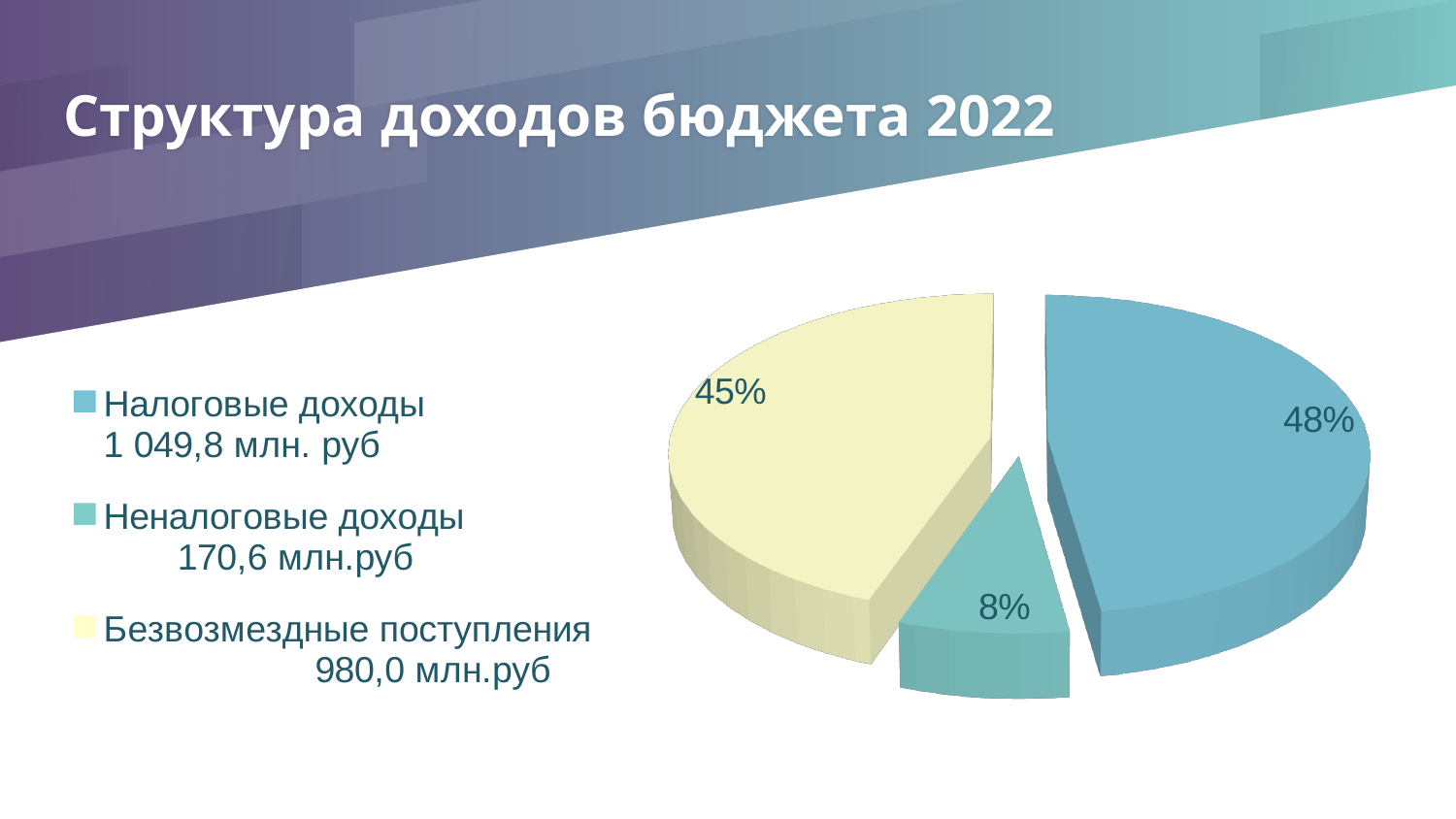
Which category has the smallest slice of the pie? Неналоговые доходы What is the title of the slide containing the pie chart? Структура доходов бюджета 2022 What share of the pie does Неналоговые доходы take? 8% What kind of chart is shown on the slide? pie chart What share of the pie does Безвозмездные поступления take? 45% How many slices does the pie chart have? 3 Which category has the largest slice of the pie? Налоговые доходы What share of the pie does Налоговые доходы take? 48% How many entries does the legend list? 3 What is the difference in percentage points between the Налоговые доходы slice and the Неналоговые доходы slice? 40 What amount in млн. руб does the legend give for Безвозмездные поступления? 980,0 млн.руб Which slice is larger, Безвозмездные поступления or Неналоговые доходы? Безвозмездные поступления